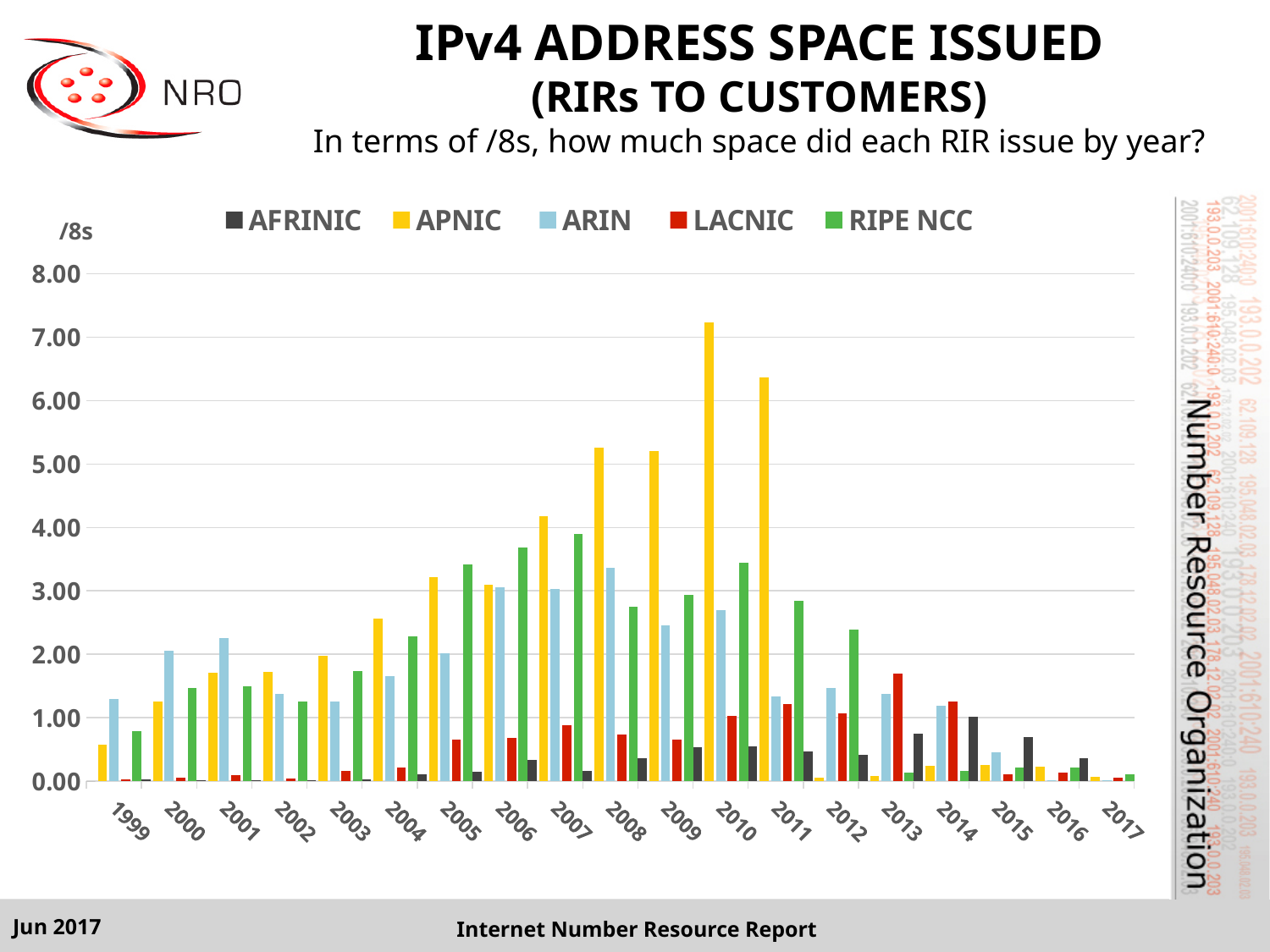
Which RIR issued the most IPv4 address space in 2013? LACNIC Is the value for APNIC in 2011 greater or less than 6.00? greater Which issued more IPv4 address space in 2000, ARIN or APNIC? ARIN Is the value for LACNIC in 2013 greater or less than 1.00? greater How many series does the legend list? 5 In which year did APNIC issue the most IPv4 address space? 2010 What unit is shown on the y axis label? /8s How many years are shown along the x axis? 19 Do the APNIC values rise or fall from 2011 to 2017? fall Is the value for APNIC in 2010 greater or less than 7.00? greater What kind of chart is shown on the slide? bar chart Which RIR issued the most IPv4 address space in 2010? APNIC